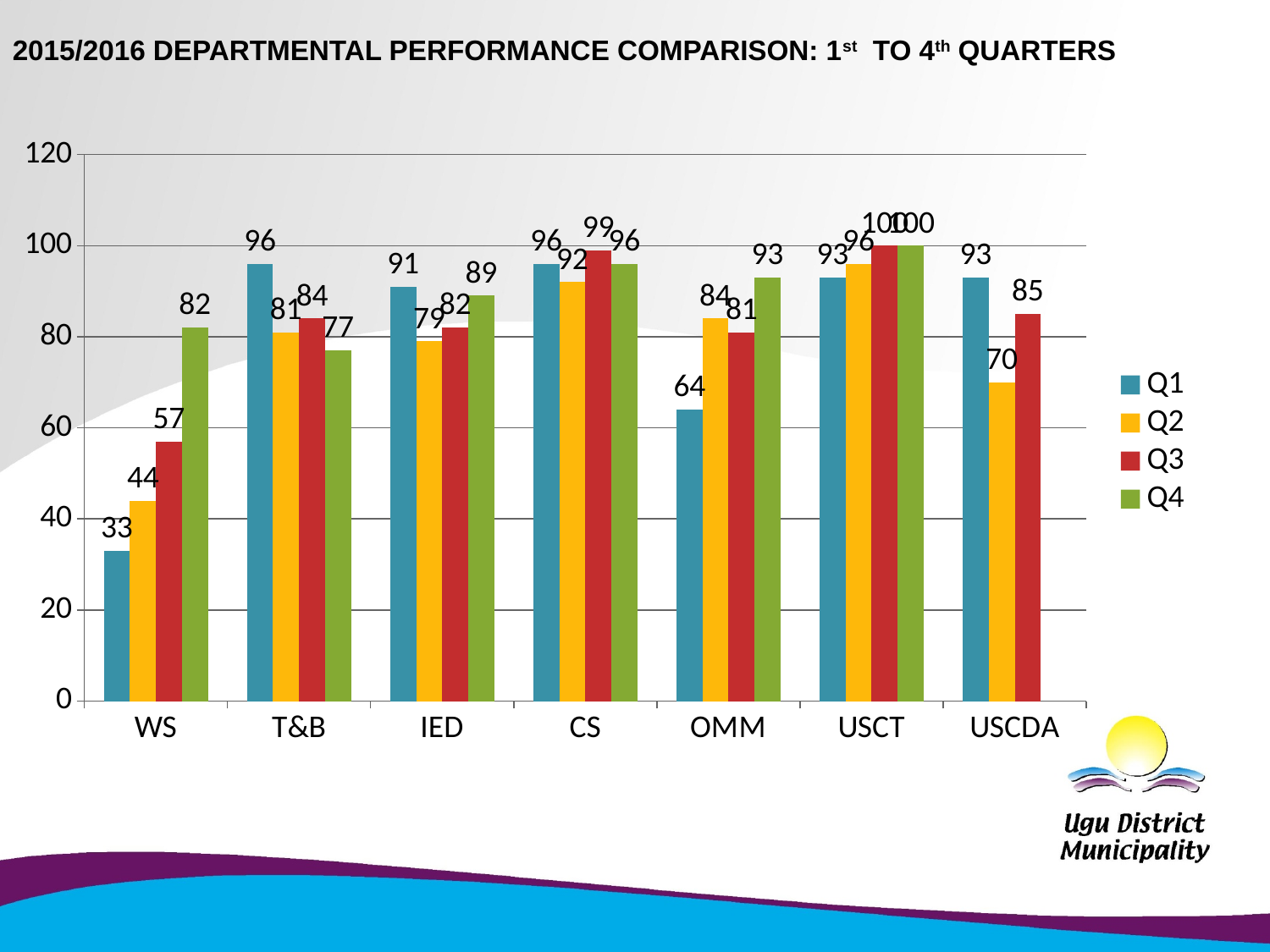
How many series does the legend list? 4 How many departments are shown on the x axis? 7 What kind of chart is shown on the slide? bar chart What is the Q2 value for USCDA? 70 Do the values for WS rise or fall from Q1 to Q4? rise Which is larger for T&B, the Q1 value or the Q4 value? Q1 What is the difference between the Q4 and Q1 values for WS? 49 Which department has the lowest Q1 value? WS Is the Q1 value for OMM greater or less than 80? less What is the Q1 value for WS? 33 Which department has the highest Q3 value? USCT What is the Q4 value for OMM? 93